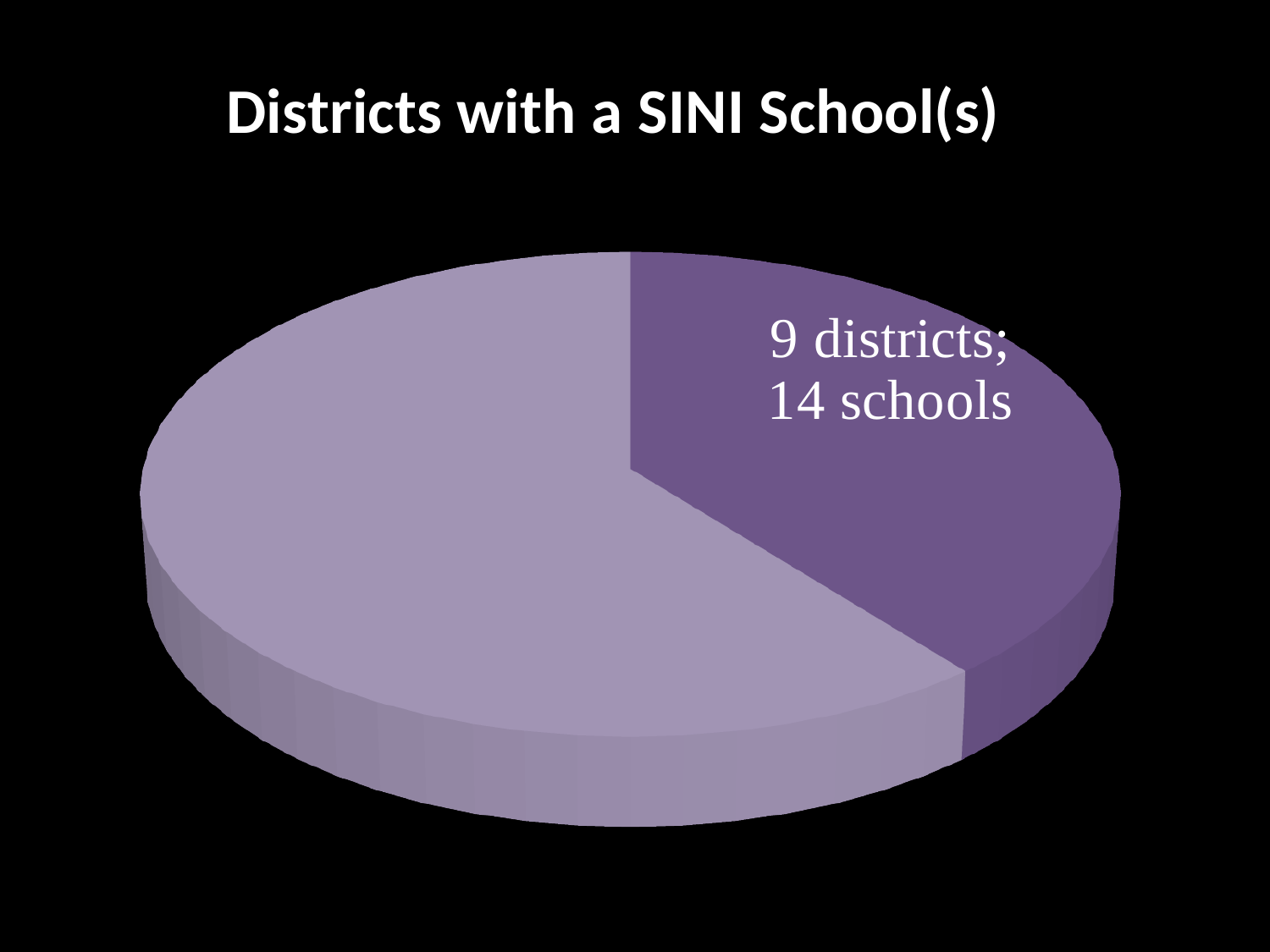
Which slice is larger: the darker purple slice labelled "9 districts; 14 schools" or the lighter unlabelled slice? the lighter unlabelled slice Does the pie chart include a legend? No How many slices does the pie chart have? 2 What kind of chart is shown on the slide? pie chart What label is printed on the darker purple slice of the pie chart? 9 districts; 14 schools Is the slice labelled "9 districts; 14 schools" the larger or the smaller slice of the pie? smaller What is the title of the chart? Districts with a SINI School(s) How many schools does the labelled slice of the pie chart represent? 14 schools How many districts does the labelled slice of the pie chart represent? 9 districts